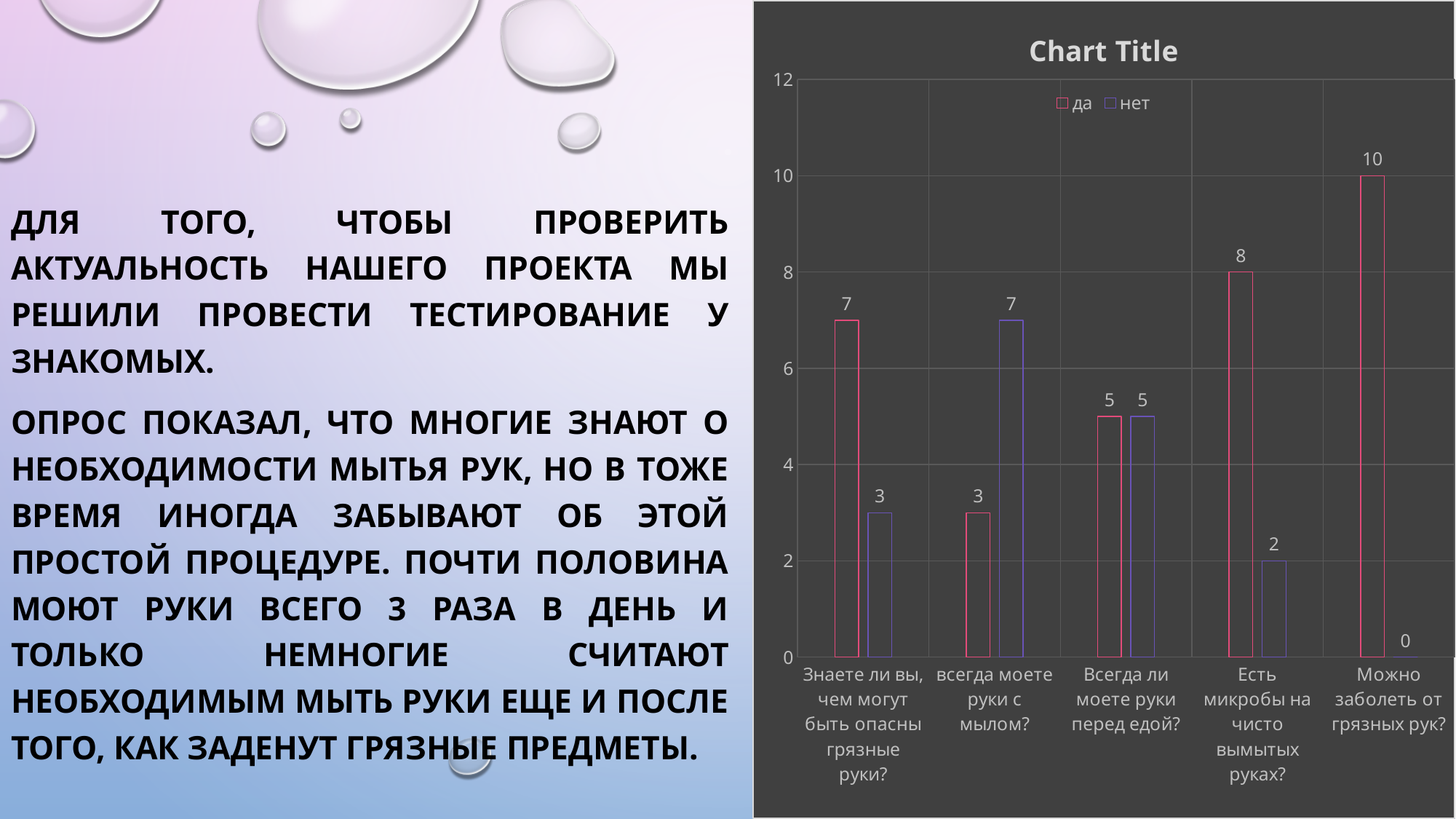
How many series does the chart legend list? 2 What is the value of the "нет" series for "всегда моете руки с мылом?"? 7 Which category has the highest "да" value? Можно заболеть от грязных рук? How many categories (questions) are shown on the x axis of the chart? 5 What is the value of the "нет" series for "Есть микробы на чисто вымытых руках?"? 2 What is the value of the "да" series for "Можно заболеть от грязных рук?"? 10 What kind of chart is shown on the slide? bar chart What is the difference between the "да" and "нет" values for "Знаете ли вы, чем могут быть опасны грязные руки?"? 4 What is the title of the chart? Chart Title What is the total of the "да" and "нет" values for "Всегда ли моете руки перед едой?"? 10 Which category has the lowest "нет" value? Можно заболеть от грязных рук? For "всегда моете руки с мылом?", which is larger, the "да" value or the "нет" value? нет